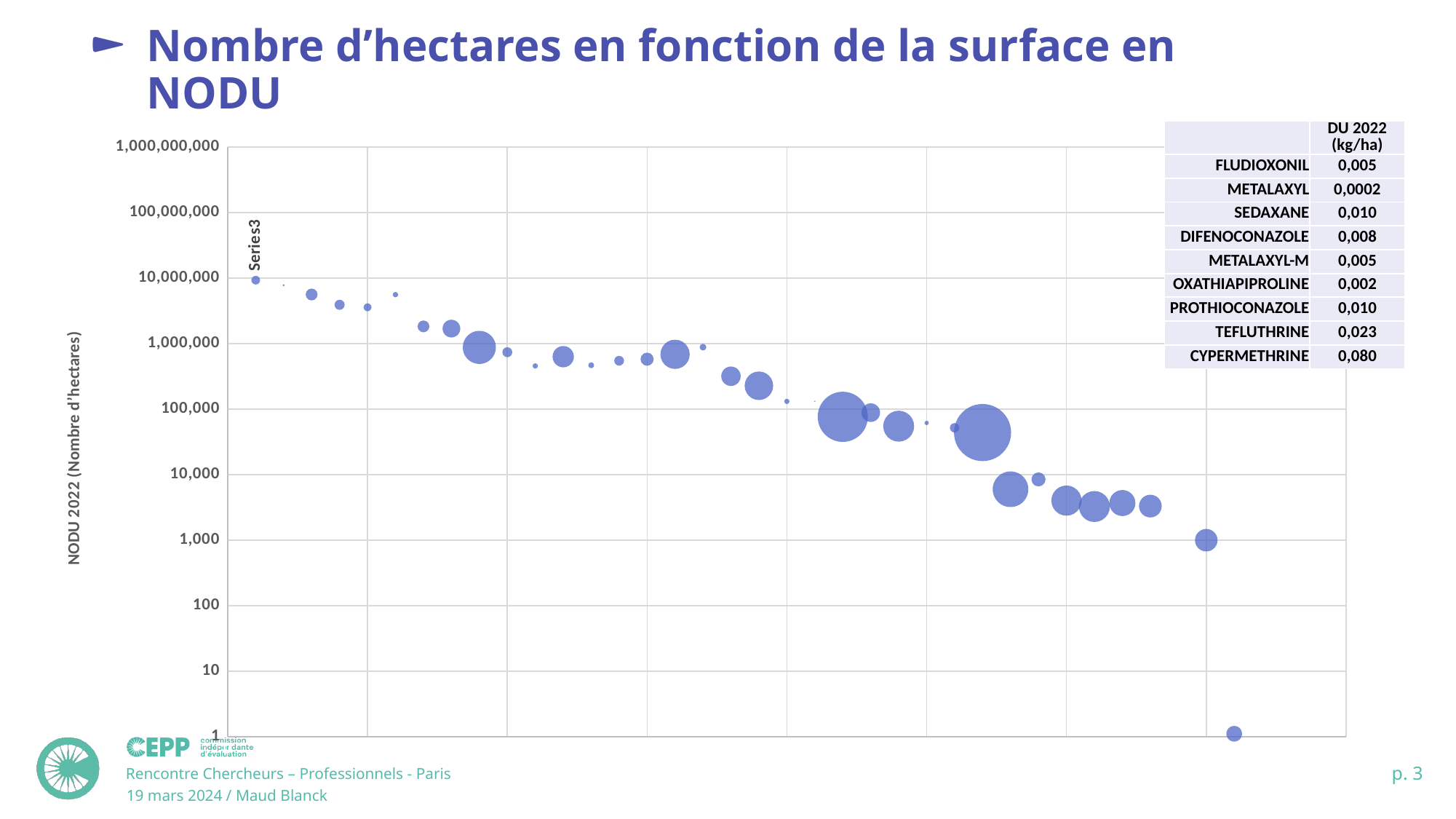
Is the value of the highest bubble on the chart greater or less than 100,000,000? less What kind of chart is shown on the slide? bubble chart Is the value of the leftmost bubble on the chart greater or less than 1,000,000? greater Do the bubble values on the chart generally rise or fall from left to right along the x axis? fall Is the value of the lowest bubble on the chart greater or less than 10? less What series name is printed on the chart? Series3 What is the title of the y axis of the chart? NODU 2022 (Nombre d'hectares)